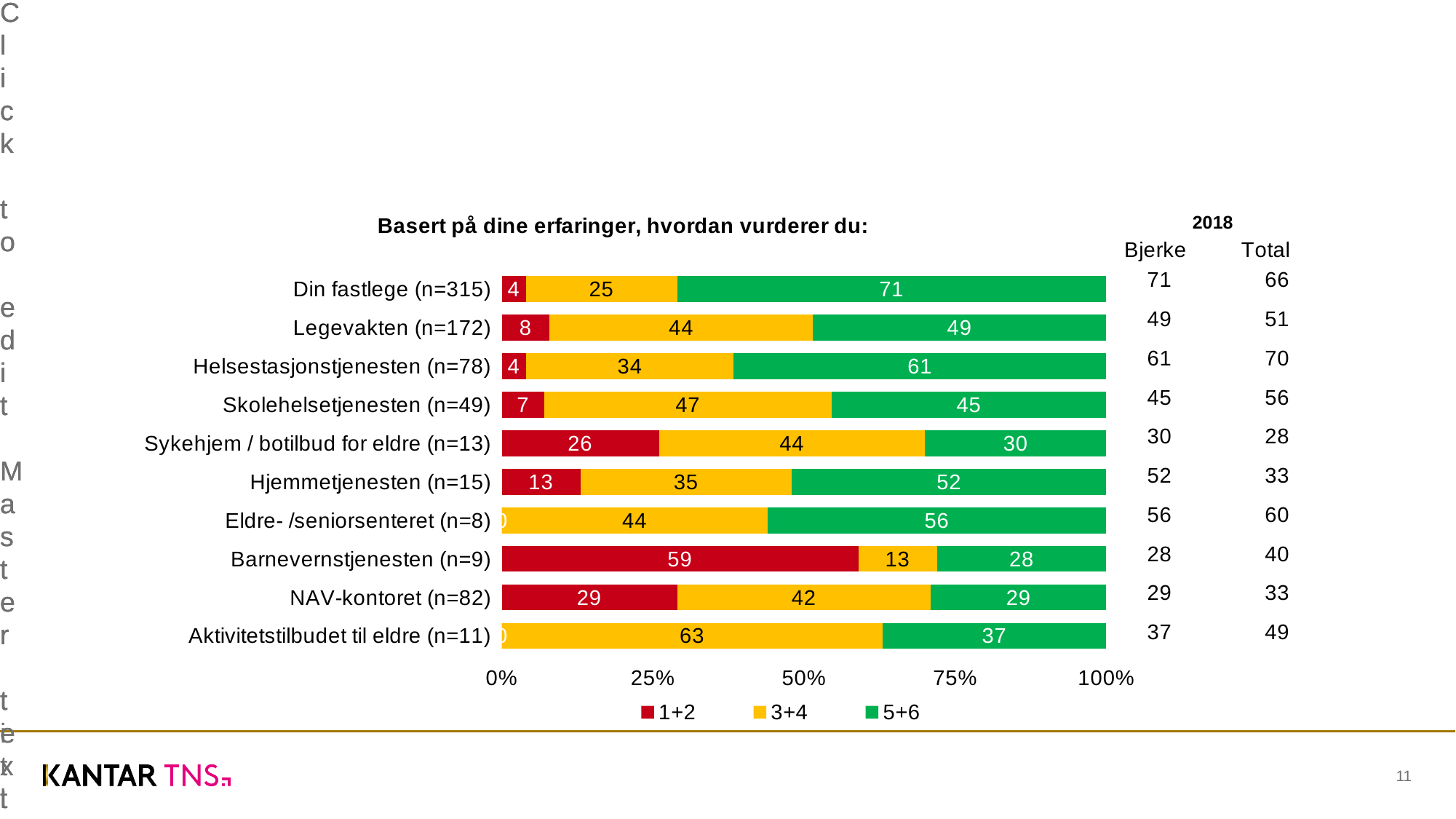
Which has a larger 3+4 value, Legevakten (n=172) or Hjemmetjenesten (n=15)? Legevakten (n=172) What is the value of the 5+6 segment for Din fastlege (n=315)? 71 How many series does the legend list? 3 What is the title of the chart? Basert på dine erfaringer, hvordan vurderer du: What is the value of the 1+2 segment for Barnevernstjenesten (n=9)? 59 What is the total of the stacked bar for NAV-kontoret (n=82)? 100 Which category has the highest 5+6 value? Din fastlege (n=315) Which category has the highest 1+2 value? Barnevernstjenesten (n=9) What is the difference between the 5+6 values for Helsestasjonstjenesten (n=78) and Skolehelsetjenesten (n=49)? 16 What type of chart is shown on the slide? Stacked bar chart How many categories (services) are plotted in the chart? 10 What is the value of the 3+4 segment for Aktivitetstilbudet til eldre (n=11)? 63